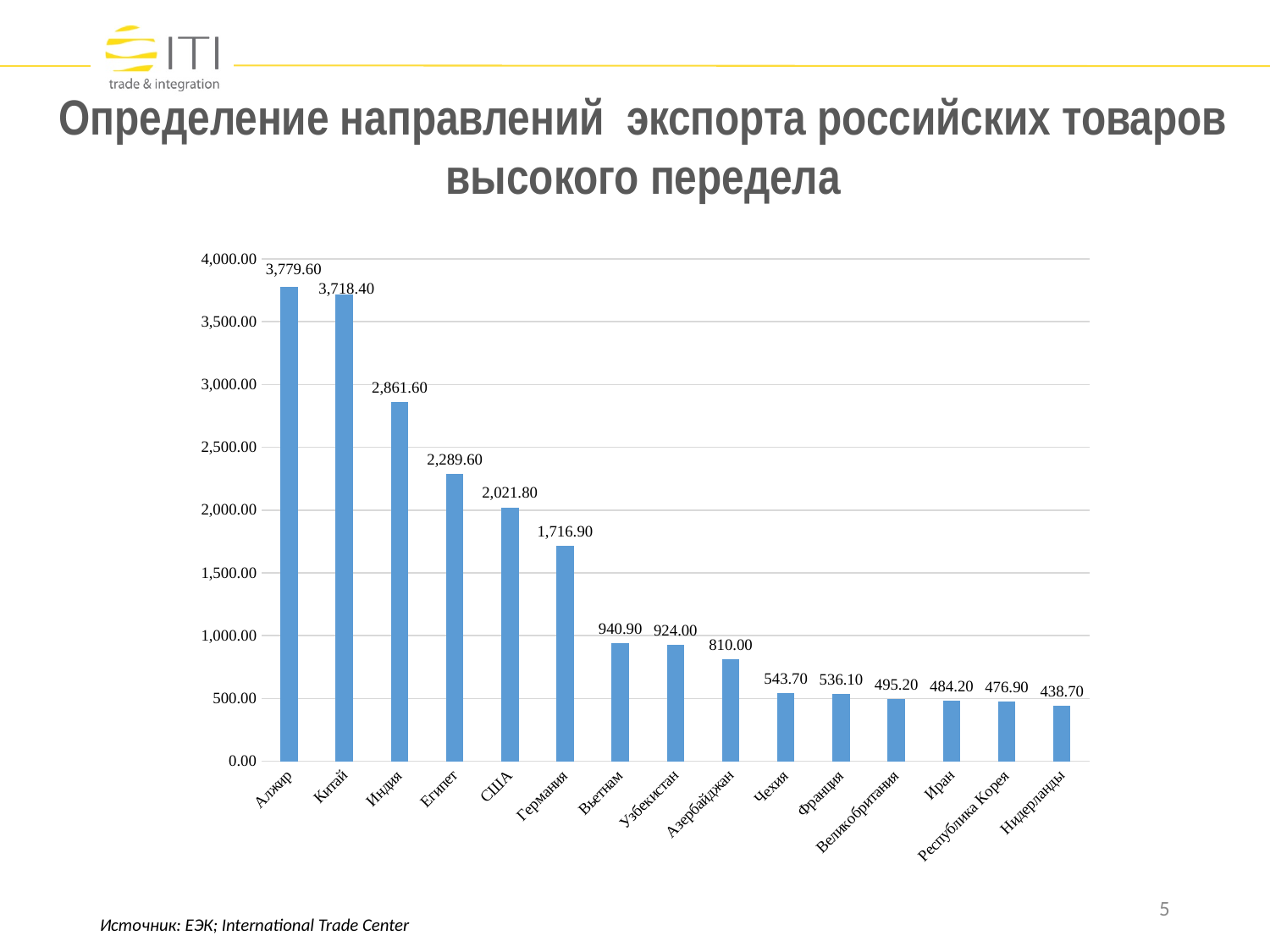
What is the value for Узбекистан? 924.00 What is the difference between the values for Египет and США? 267.80 Which is larger, the value for Вьетнам or the value for Азербайджан? Вьетнам What kind of chart is shown on the slide? Bar chart Which country has the highest value? Алжир What is the value for Индия? 2,861.60 Do the values rise or fall from left to right along the x axis? Fall What is the value for Германия? 1,716.90 How many countries are shown in the chart? 15 What is the difference between the values for Алжир and Китай? 61.20 What is the value for Нидерланды? 438.70 Which country has the lowest value? Нидерланды